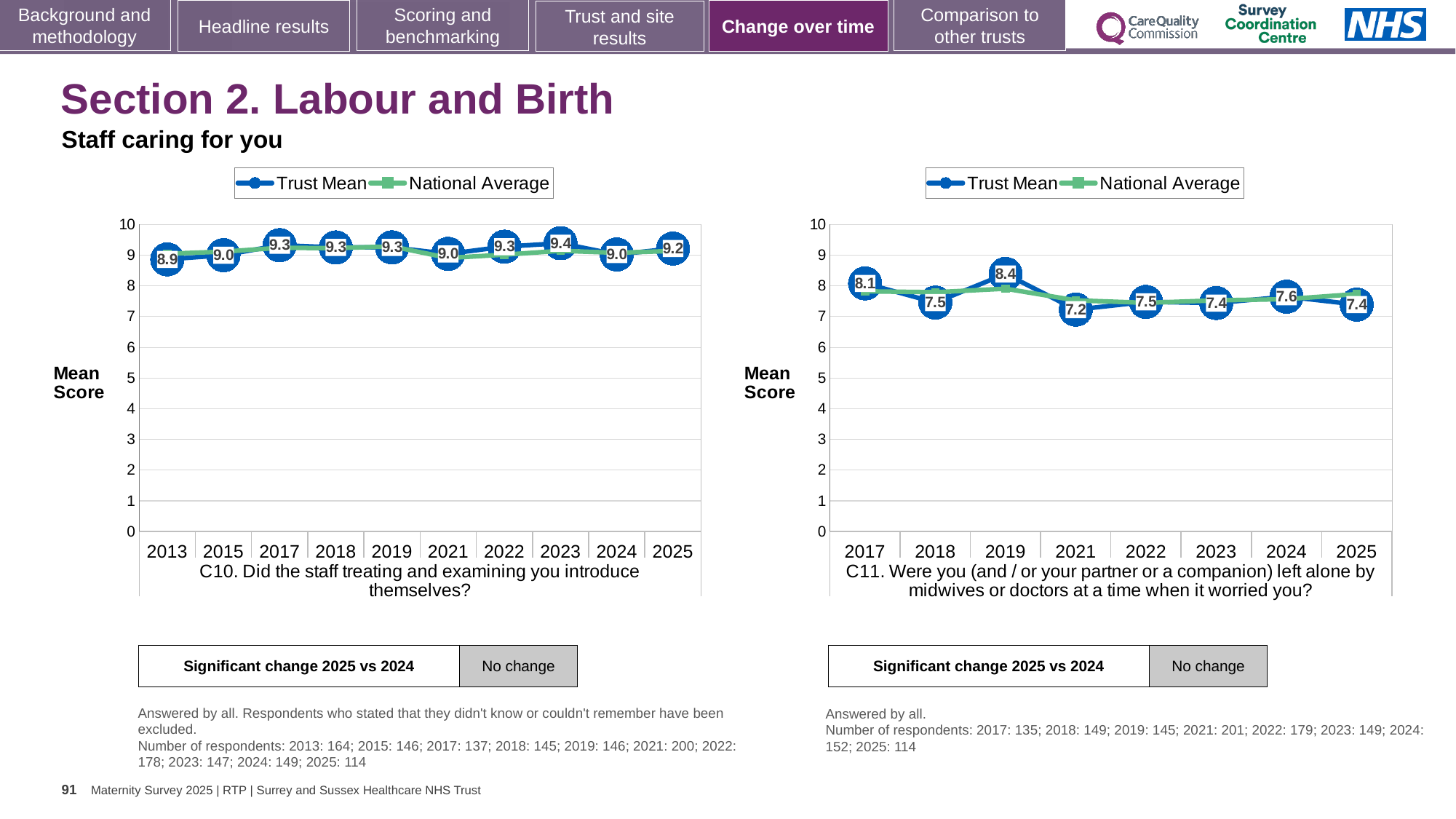
In the C11 chart (right), is the Trust Mean score for 2025 greater or less than 8? less In the C11 chart (right), which year has the lowest Trust Mean score? 2021 In the C11 chart (right), how many series does the legend list? 2 In the C10 chart (left), which year has the highest Trust Mean score? 2023 What type of chart is the C11 chart (right)? Line chart In the C11 chart (right), what is the Trust Mean score for 2019? 8.4 In the C10 chart (left), what is the Trust Mean score for 2013? 8.9 In the C11 chart (right), what is the difference between the Trust Mean scores for 2019 and 2021? 1.2 In the C10 chart (left), what is the difference between the Trust Mean scores for 2023 and 2013? 0.5 In the C10 chart (left), what is the Trust Mean score for 2025? 9.2 In the C10 chart (left), how many years are plotted on the x axis? 10 In the C11 chart (right), is the Trust Mean score for 2017 or 2018 higher? 2017